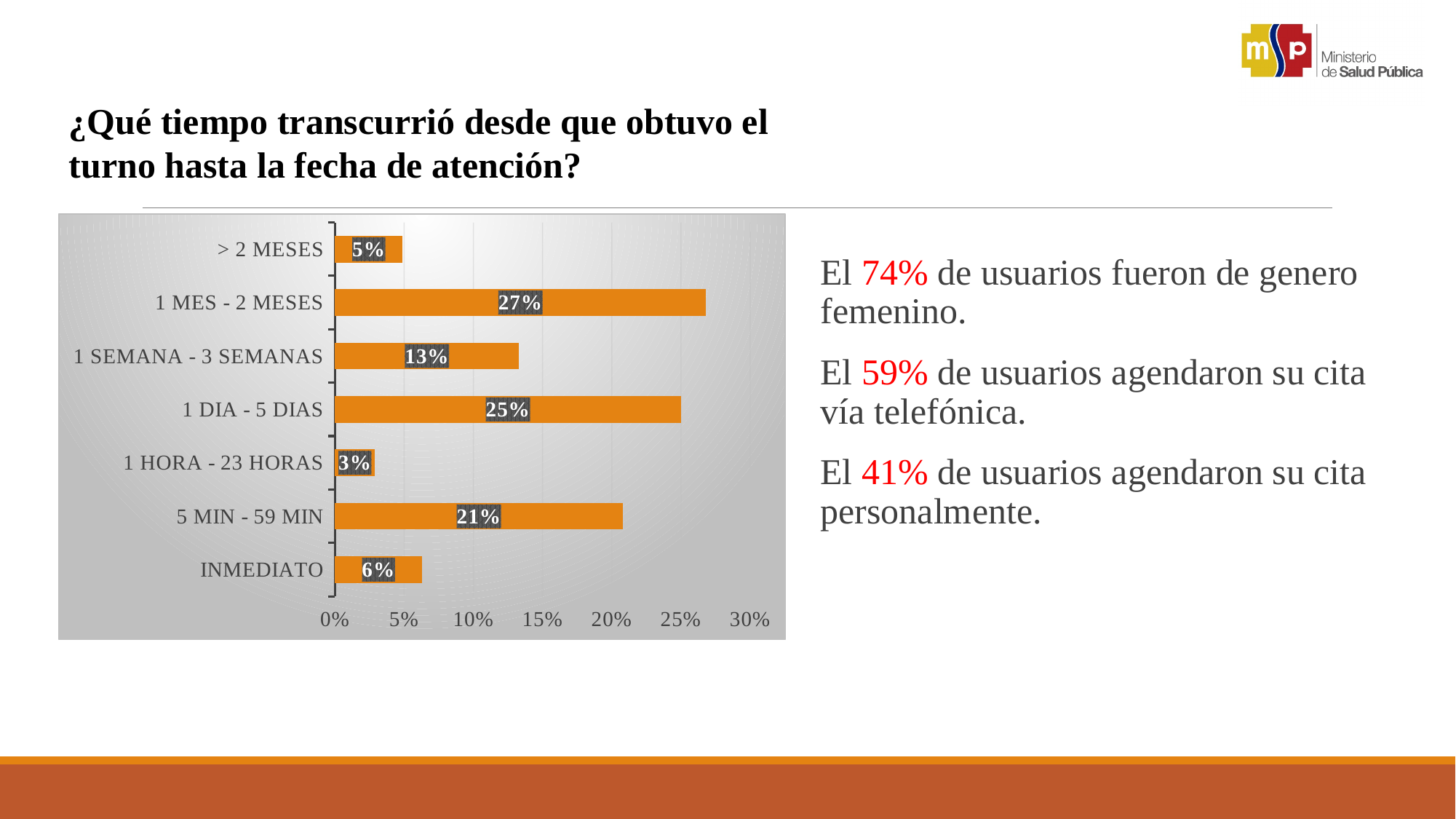
What is the value for INMEDIATO? 6% What is the value for 1 MES - 2 MESES? 27% What is the value for 5 MIN - 59 MIN? 21% How many categories are shown in the chart? 7 What is the difference between the values for 1 DIA - 5 DIAS and 1 SEMANA - 3 SEMANAS? 12% What kind of chart is shown on the slide? bar chart Which category has the lowest value? 1 HORA - 23 HORAS Is the value for 1 DIA - 5 DIAS greater or less than 20%? greater What colour are the bars in the chart? orange Which category has the highest value? 1 MES - 2 MESES What is the value for 1 HORA - 23 HORAS? 3% Which is larger, the value for 5 MIN - 59 MIN or the value for 1 SEMANA - 3 SEMANAS? 5 MIN - 59 MIN